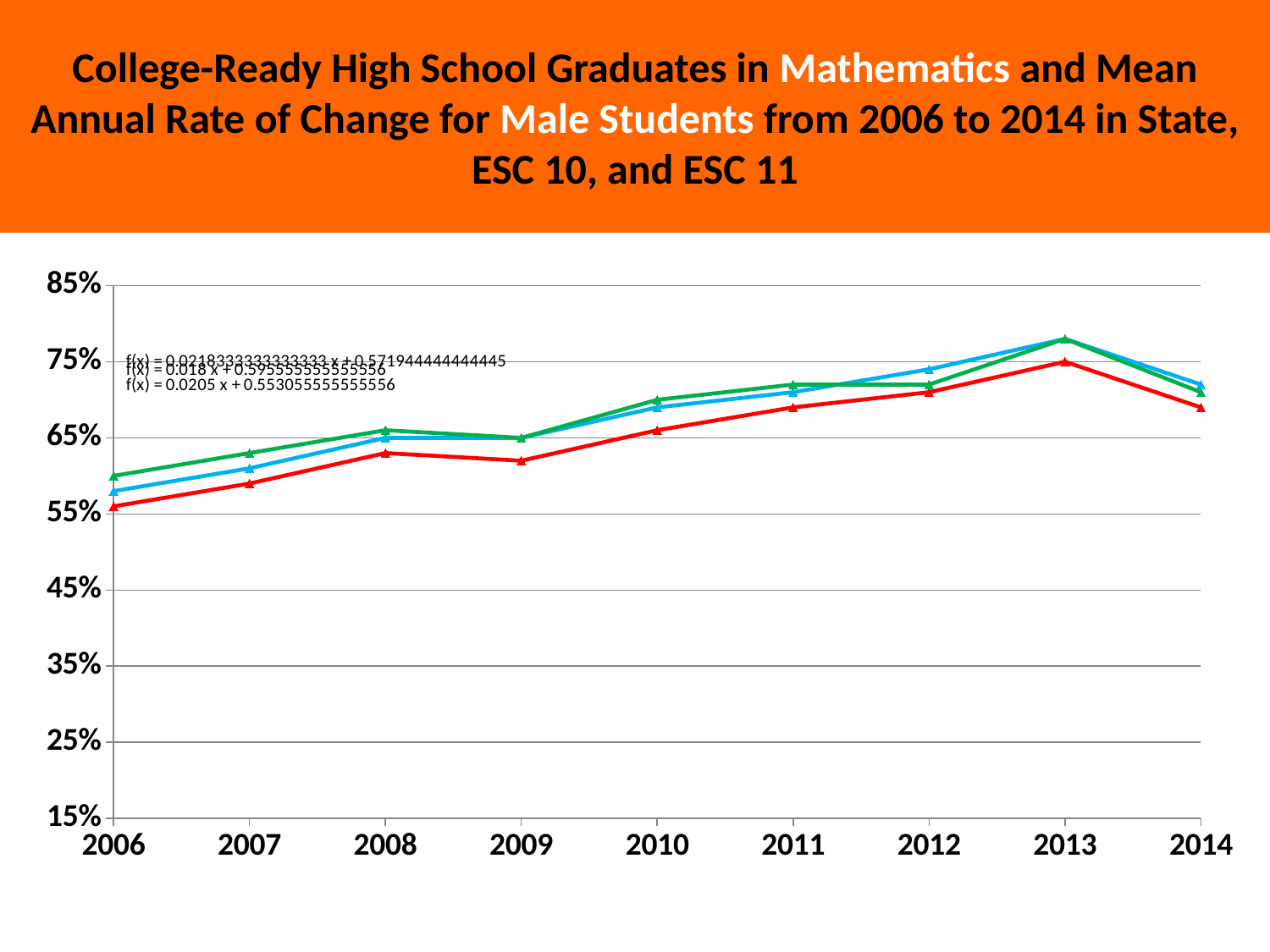
Do the lines generally rise or fall from 2006 to 2013? rise How many years are plotted along the x axis? 9 Is the value of the red line in 2006 greater or less than 65%? less In 2006, which line has the higher value, the red line or the green line? green line How many lines are plotted on the chart? 3 Is the value of the blue line in 2013 greater or less than 75%? greater In which year is the red line at its lowest value? 2006 In which year does the red line reach its highest value? 2013 What kind of chart is shown on the slide? line chart Is the value of the green line in 2006 greater or less than 65%? less Which subject is named in the chart title? Mathematics